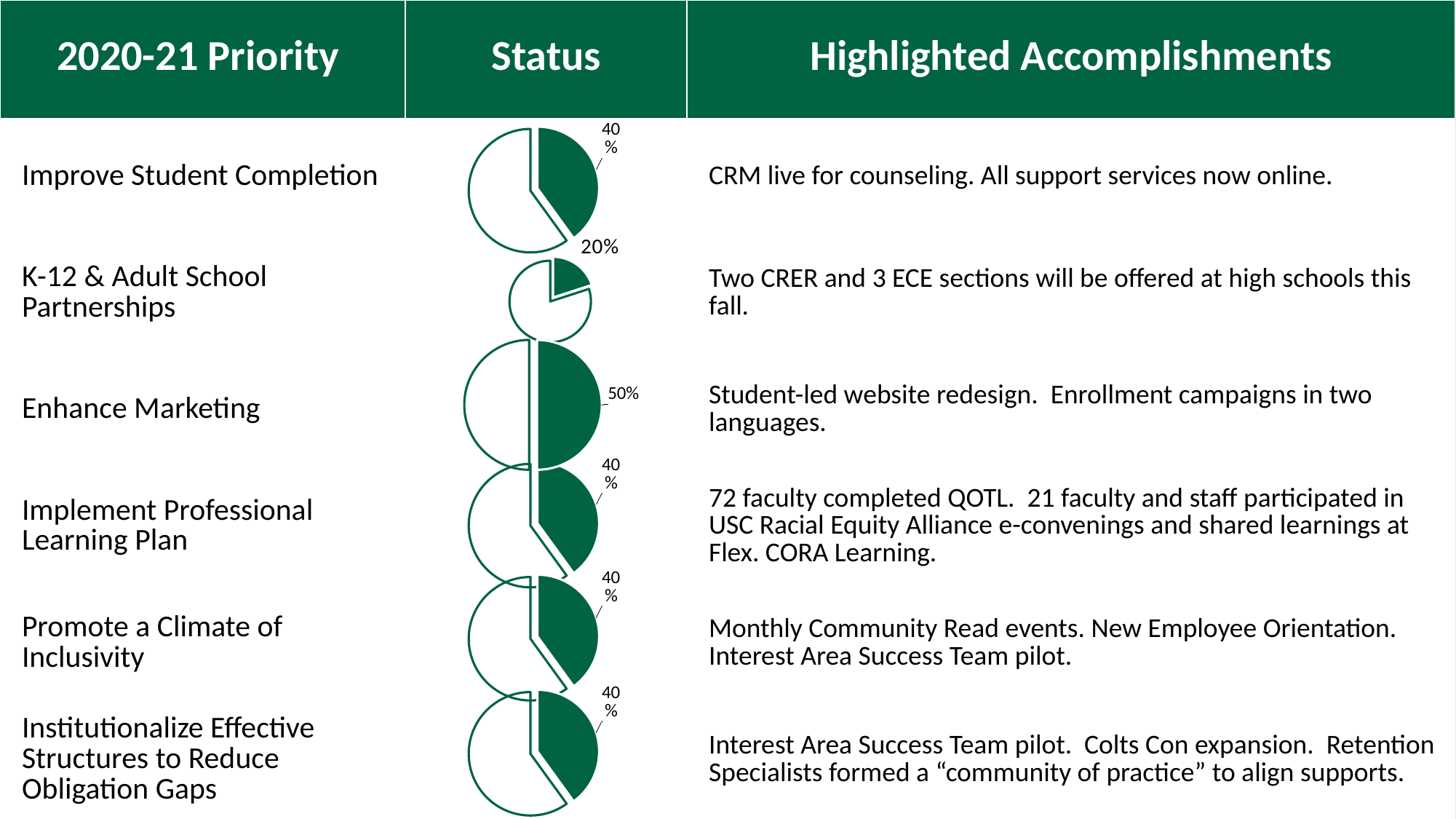
What kind of chart is shown in the Status column next to "Improve Student Completion"? pie chart In the pie chart next to "Institutionalize Effective Structures to Reduce Obligation Gaps", what percentage is labelled on the filled green slice? 40% In the pie chart next to "Implement Professional Learning Plan", what percentage is labelled on the filled green slice? 40% In the pie chart next to "Improve Student Completion", what percentage is labelled on the filled green slice? 40% In the pie chart next to "Enhance Marketing", what percentage is labelled on the filled green slice? 50% How many pie charts are shown in the Status column of the slide? 6 In the pie chart next to "Promote a Climate of Inclusivity", what percentage is labelled on the filled green slice? 40% What is the difference between the labelled percentage in the "Enhance Marketing" pie chart and the labelled percentage in the "K-12 & Adult School Partnerships" pie chart? 30% Which priority's pie chart in the Status column shows the lowest labelled percentage? K-12 & Adult School Partnerships In the pie chart next to "K-12 & Adult School Partnerships", what percentage is labelled on the filled green slice? 20% Which is larger: the labelled percentage in the "Improve Student Completion" pie chart or the labelled percentage in the "K-12 & Adult School Partnerships" pie chart? Improve Student Completion Which priority's pie chart in the Status column shows the highest labelled percentage? Enhance Marketing